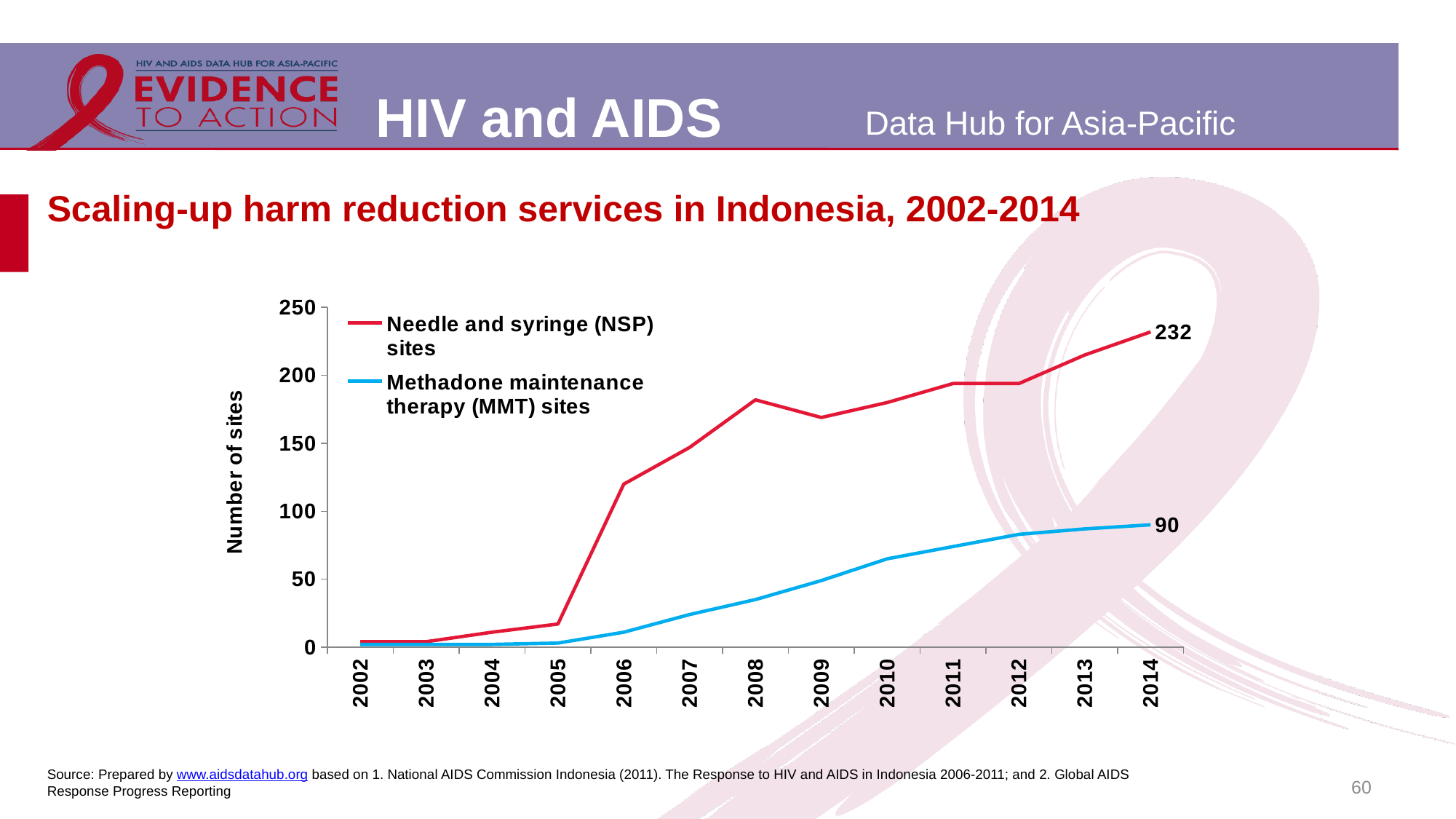
Is the number of MMT sites in 2010 greater or less than 100? less What is the difference between the number of NSP sites and MMT sites in 2014? 142 What is the number of Needle and syringe (NSP) sites in 2014? 232 What is the label of the y axis? Number of sites Is the number of NSP sites in 2005 greater or less than 50? less Is the number of NSP sites in 2008 greater or less than 150? greater How many series does the legend list? 2 Does the number of MMT sites rise or fall from 2002 to 2014? Rise In 2014, which series has the larger value: NSP sites or MMT sites? Needle and syringe (NSP) sites What is the number of Methadone maintenance therapy (MMT) sites in 2014? 90 How many years are shown on the x axis? 13 What kind of chart is shown on the slide? Line chart